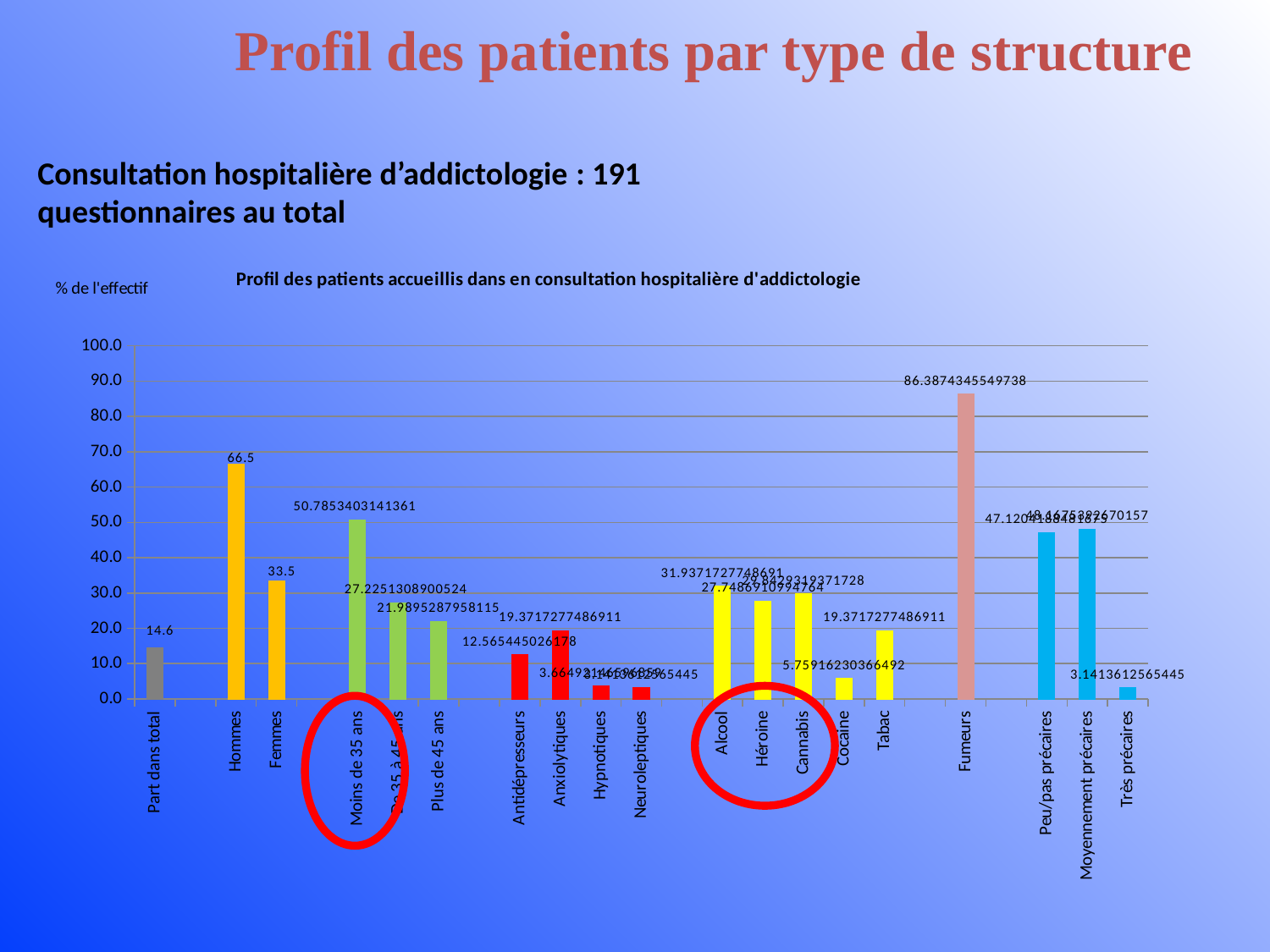
What is the label on the vertical axis of the chart? % de l'effectif Which category has the highest value? Fumeurs What is the difference between the values for Hommes and Femmes? 33 What is the value for Part dans total? 14.6 What kind of chart is shown on the slide? bar chart What is the value for Hommes? 66.5 Which is larger, the value for Alcool or the value for Tabac? Alcool Is the value for Héroine greater or less than 20? greater What is the value for Femmes? 33.5 What is the value for Moins de 35 ans? 50.7853403141361 What is the value for Fumeurs? 86.3874345549738 Is the value for Très précaires greater or less than 10? less